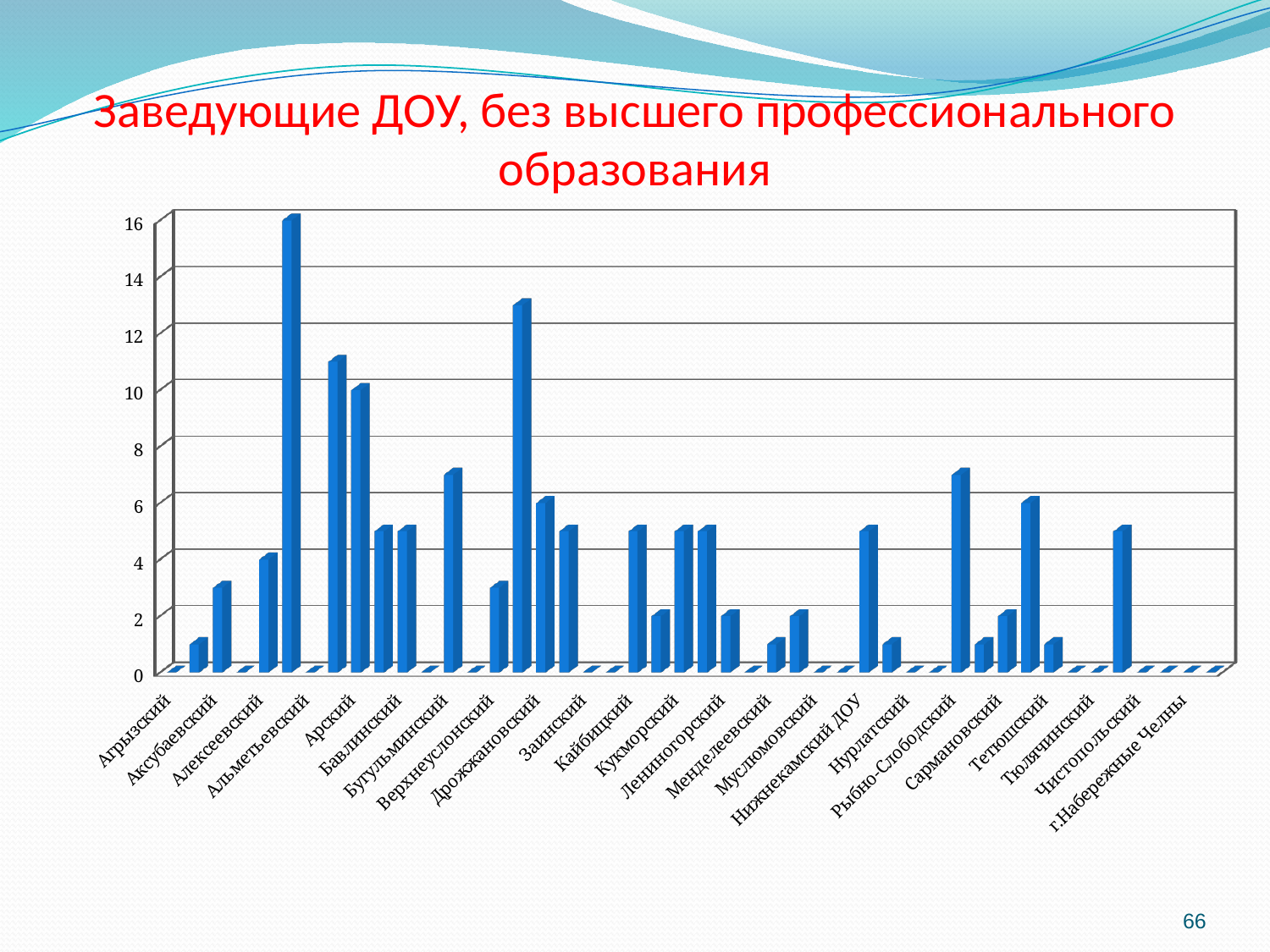
What is the maximum value shown on the vertical axis? 16 Is the tallest bar in the chart greater or less than 14? greater What is the title of the chart? Заведующие ДОУ, без высшего профессионального образования Is the second-tallest bar in the chart greater or less than 12? greater What kind of chart is shown on the slide? bar chart How many bars in the chart reach a value of 10 or more? 4 What is the highest value reached by any bar in the chart? 16